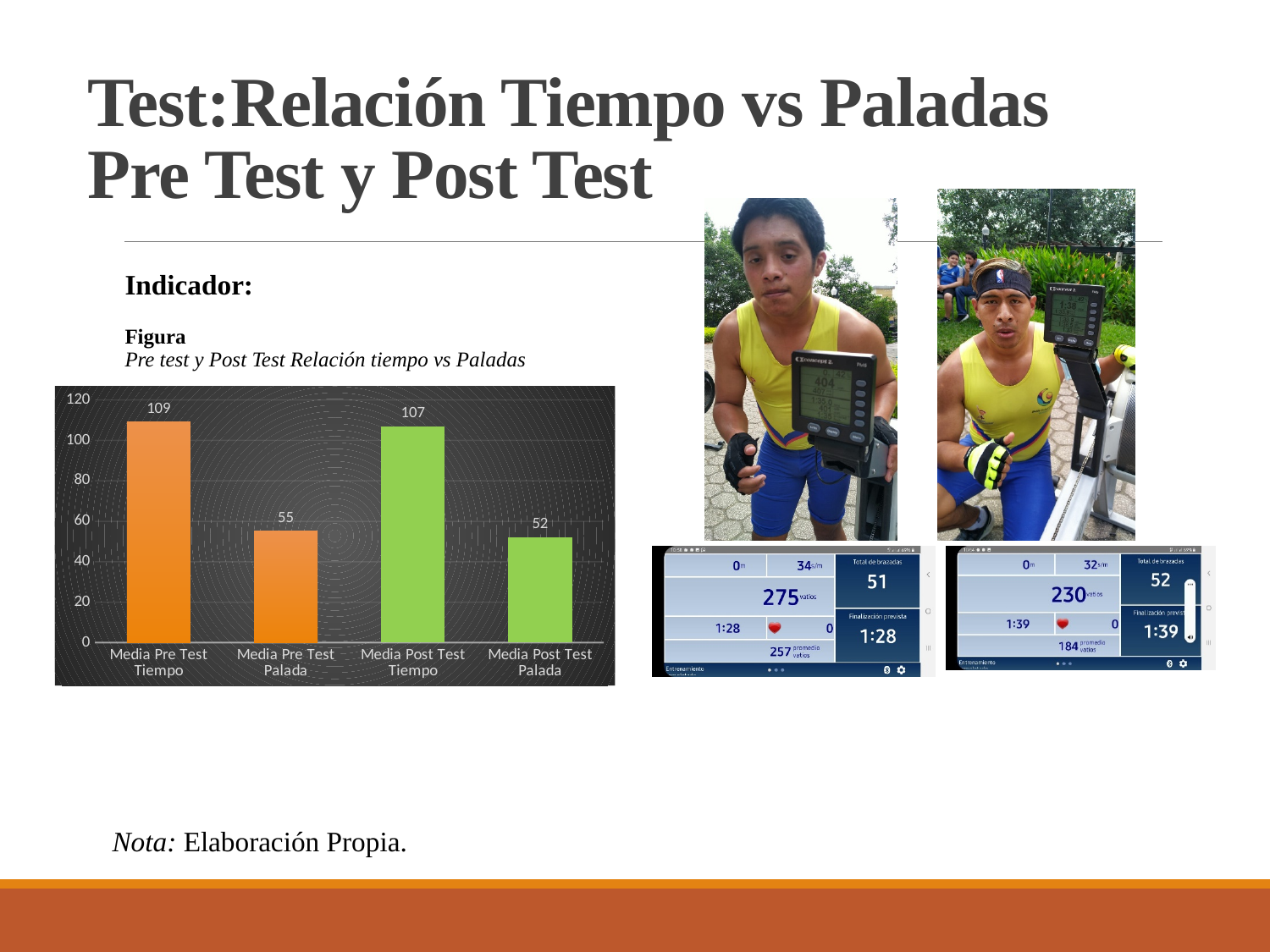
Which category has the highest value? Media Pre Test Tiempo Which category has the lowest value? Media Post Test Palada How many categories are shown on the chart? 4 What is the value for Media Post Test Palada? 52 What is the value for Media Pre Test Tiempo? 109 Which is larger, Media Pre Test Tiempo or Media Pre Test Palada? Media Pre Test Tiempo What is the difference between Media Pre Test Tiempo and Media Post Test Tiempo? 2 Is the value for Media Post Test Tiempo greater or less than 100? greater What is the difference between Media Pre Test Palada and Media Post Test Palada? 3 What kind of chart is shown on the slide? bar chart What colour are the Post Test bars? green What is the value for Media Pre Test Palada? 55